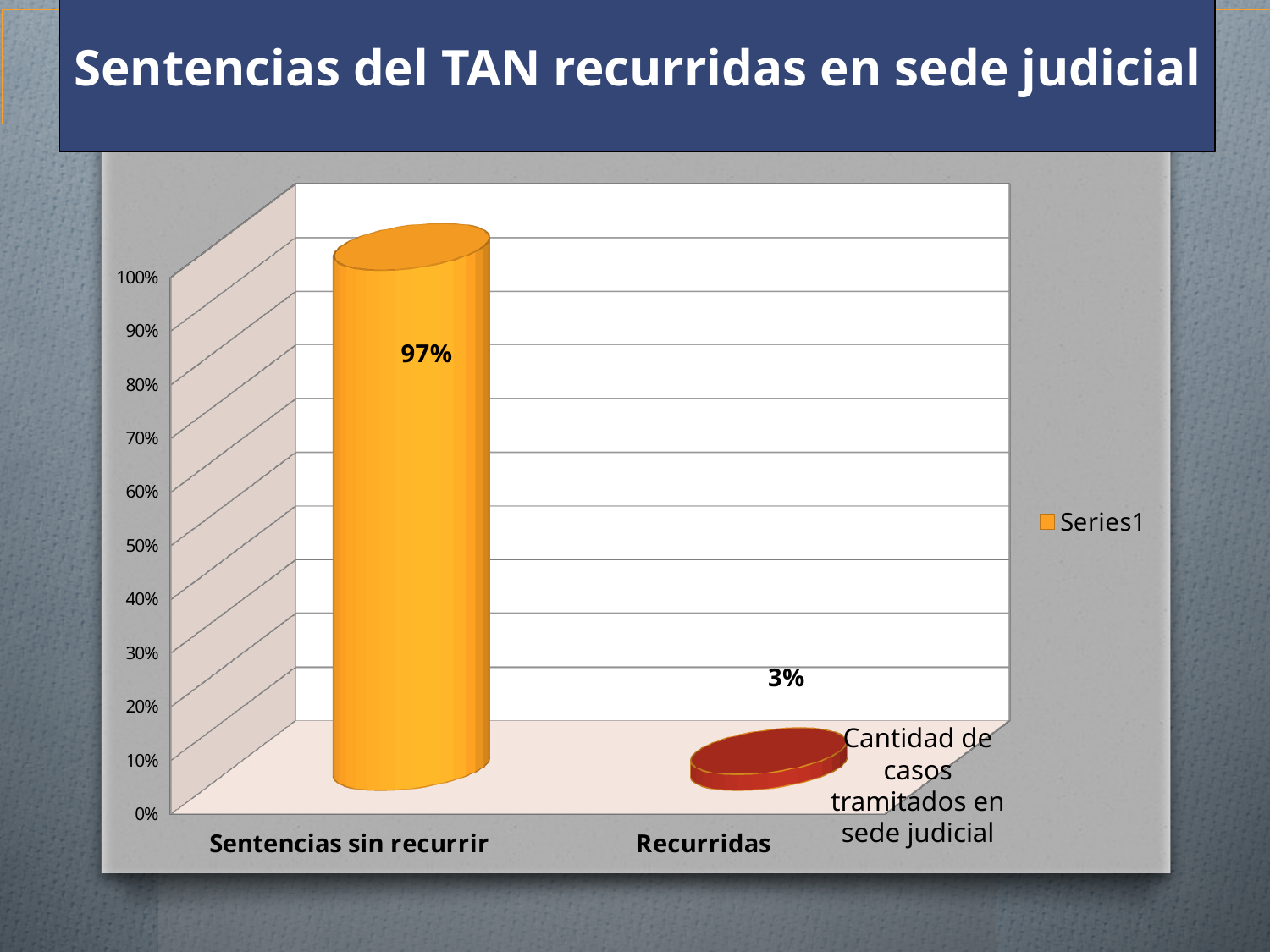
What is the value for Recurridas? 3% How many categories are shown on the x axis? 2 How many series does the legend list? 1 What kind of chart is shown on the slide? bar chart Is the value for Sentencias sin recurrir greater or less than 50%? greater Which category has the highest value? Sentencias sin recurrir Is the value for Recurridas greater or less than 10%? less Which category has the lowest value? Recurridas What is the difference between the values for Sentencias sin recurrir and Recurridas? 94% Which is larger, the value for Sentencias sin recurrir or the value for Recurridas? Sentencias sin recurrir What is the value for Sentencias sin recurrir? 97% What is the title of the slide? Sentencias del TAN recurridas en sede judicial